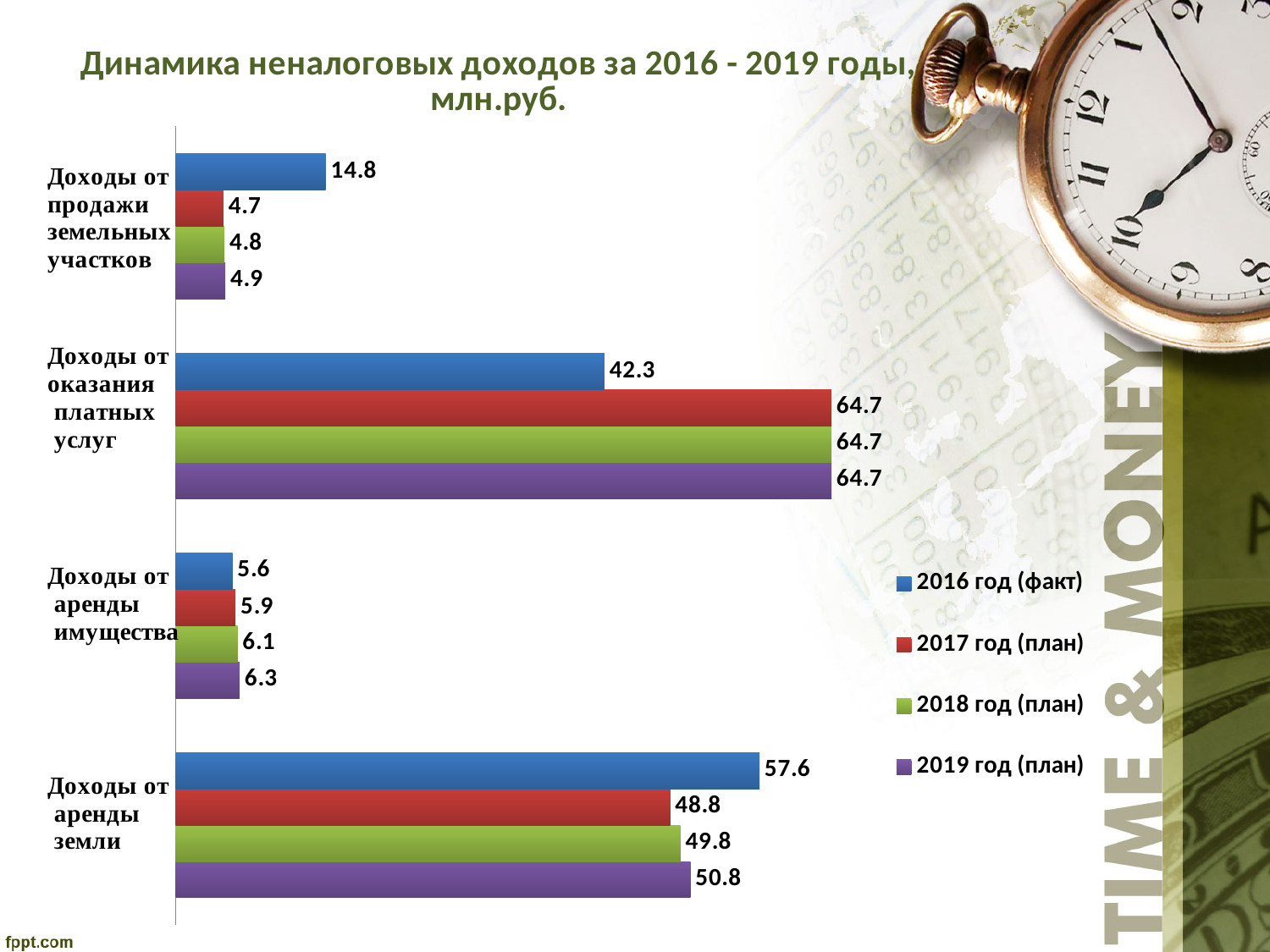
What kind of chart is shown on the slide? Bar chart What is the value for «Доходы от аренды земли» in the 2019 год (план) series? 50.8 What is the title of the chart? Динамика неналоговых доходов за 2016 - 2019 годы, млн.руб. What is the value for «Доходы от продажи земельных участков» in the 2016 год (факт) series? 14.8 What is the difference between the 2016 год (факт) and 2017 год (план) values for «Доходы от аренды земли»? 8.8 What is the value for «Доходы от оказания платных услуг» in the 2017 год (план) series? 64.7 Which category has the highest value in the 2016 год (факт) series? Доходы от аренды земли What is the value for «Доходы от аренды имущества» in the 2018 год (план) series? 6.1 How many categories are shown on the chart? 4 Which category has the lowest value in the 2019 год (план) series? Доходы от продажи земельных участков Which is larger for «Доходы от оказания платных услуг»: the 2016 год (факт) value or the 2018 год (план) value? 2018 год (план) How many series does the legend list? 4